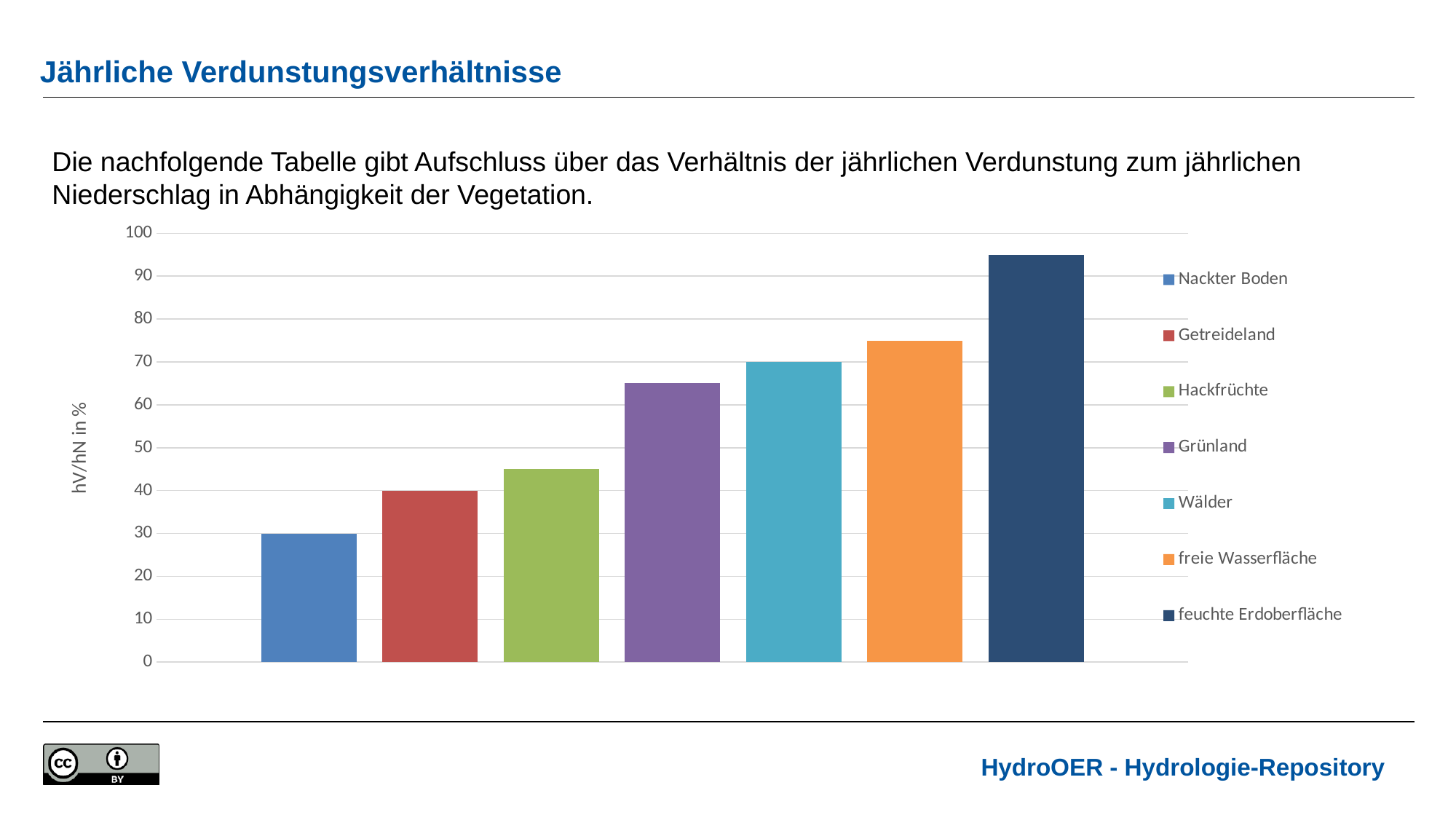
What kind of chart is shown on the slide? bar chart What is the value for Wälder? 70 How many bars are plotted in the chart? 7 Is the value for Hackfrüchte greater or less than 50? less Which is larger, the value for Grünland or the value for Hackfrüchte? Grünland What is the value for Getreideland? 40 Is the value for feuchte Erdoberfläche greater or less than 90? greater Which category has the lowest value in the chart? Nackter Boden Do the bar values rise or fall from left to right across the chart? rise How many entries does the legend list? 7 What is the value for Nackter Boden? 30 Which category has the highest value in the chart? feuchte Erdoberfläche